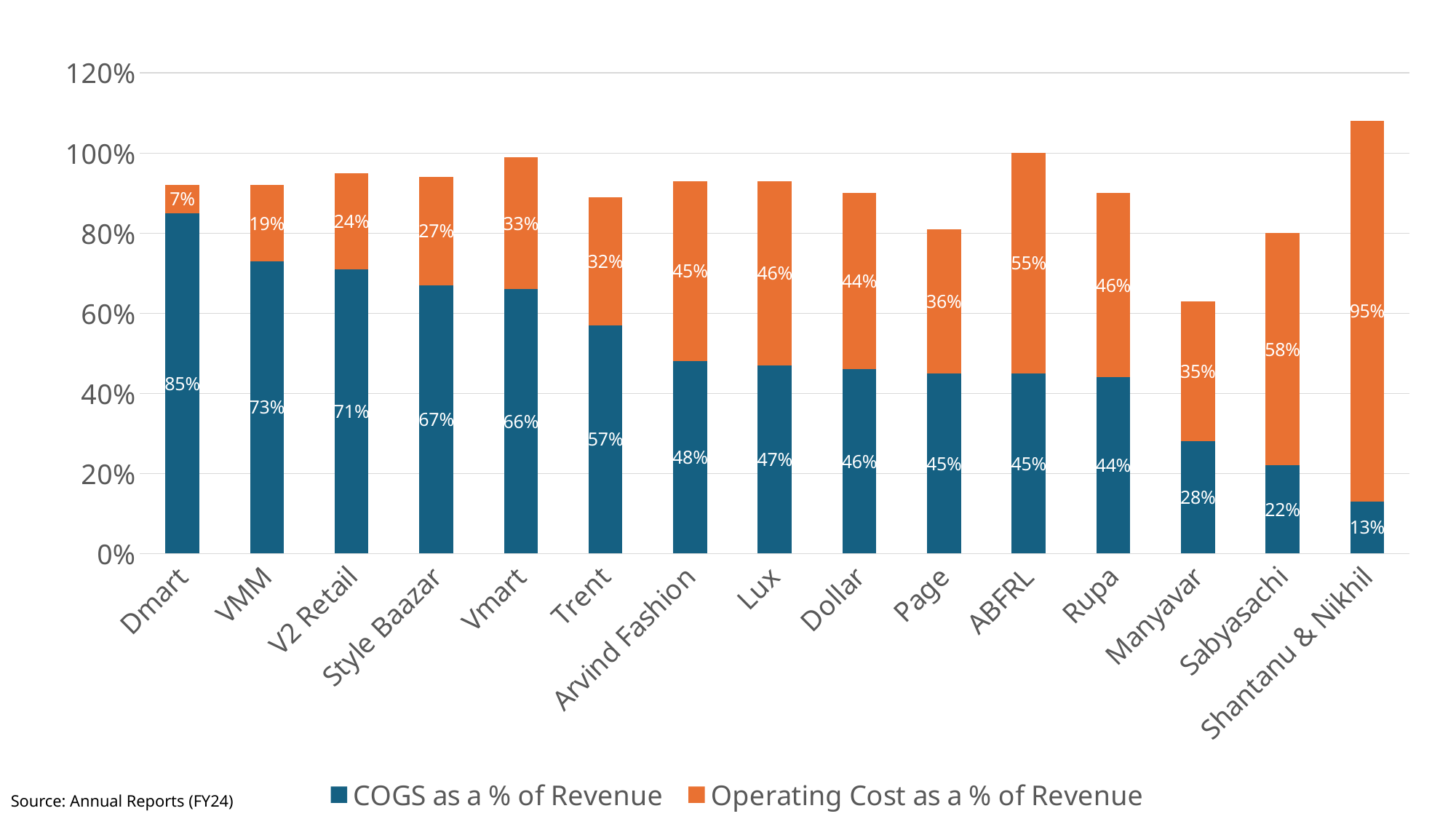
Which company has the highest Operating Cost as a % of Revenue? Shantanu & Nikhil Which has a higher COGS as a % of Revenue, Trent or Lux? Trent What is the COGS as a % of Revenue for Dmart? 85% What is the difference in COGS as a % of Revenue between Dmart and VMM? 12 percentage points What is the total of the stacked bar for ABFRL (COGS plus Operating Cost as a % of Revenue)? 100% What is the Operating Cost as a % of Revenue for Vmart? 33% Which company has the highest COGS as a % of Revenue? Dmart What kind of chart is shown on the slide? Stacked bar chart How many companies are shown on the x axis? 15 Which company has the lowest Operating Cost as a % of Revenue? Dmart How many series does the legend list? 2 What is the Operating Cost as a % of Revenue for Sabyasachi? 58%